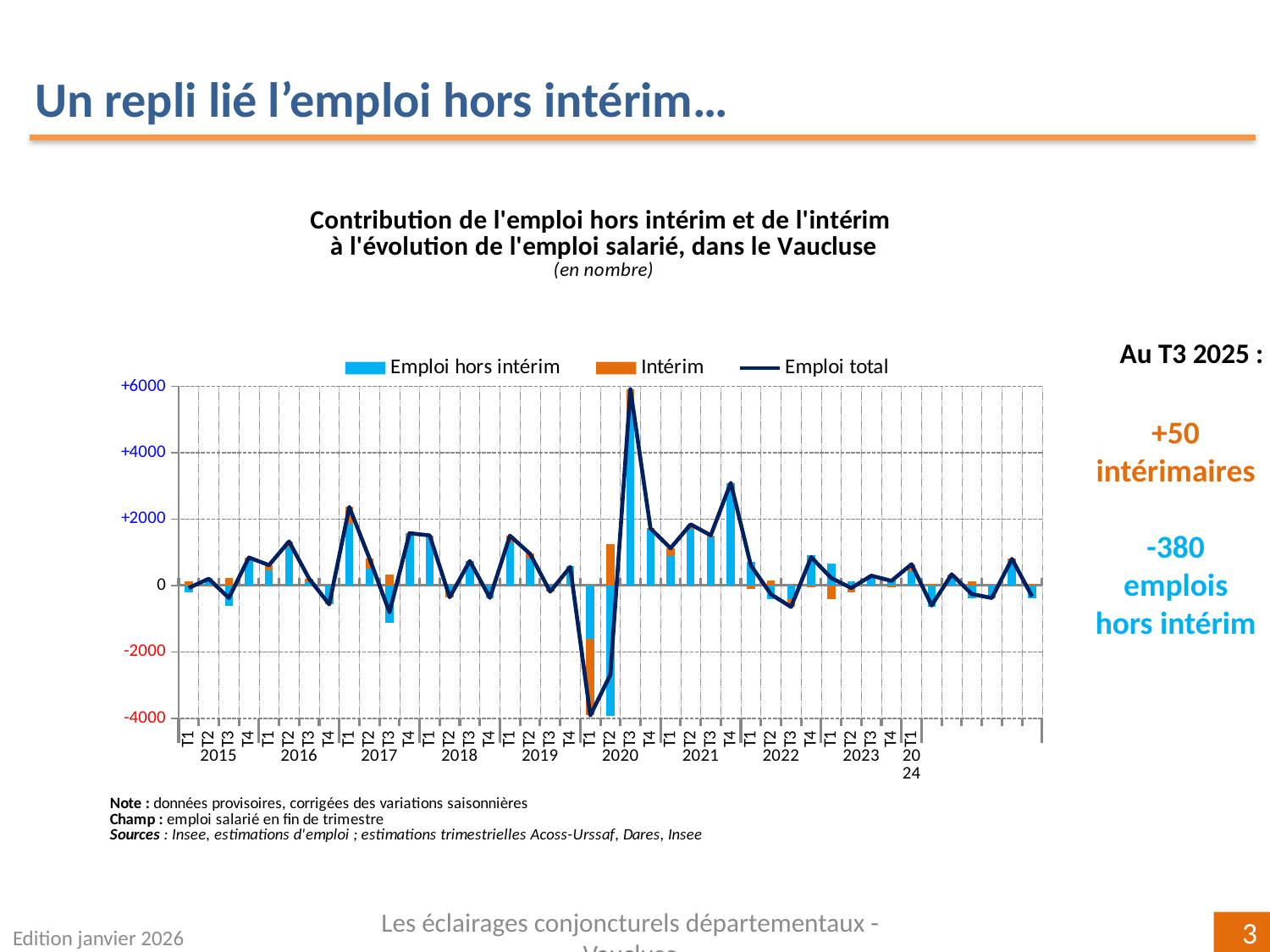
Is the Emploi total value for T4 2021 greater or less than 2000? greater Which series are listed in the chart legend? Emploi hors intérim, Intérim, Emploi total Which is larger, the Emploi total value for T3 2020 or for T4 2021? T3 2020 Does the Emploi total line rise or fall between T1 2020 and T3 2020? rise In which quarter does the Emploi total line reach its lowest value? T1 2020 Is the Emploi hors intérim value for T1 2020 greater or less than -2000? greater What kind of chart is shown on the slide? A combined bar and line chart According to the slide, what is the change in emplois hors intérim at T3 2025? -380 In which quarter does the Emploi total line reach its highest value? T3 2020 What is the title of the chart? Contribution de l'emploi hors intérim et de l'intérim à l'évolution de l'emploi salarié, dans le Vaucluse Is the Emploi hors intérim value for T3 2020 greater or less than 4000? greater How many series does the chart legend list? 3